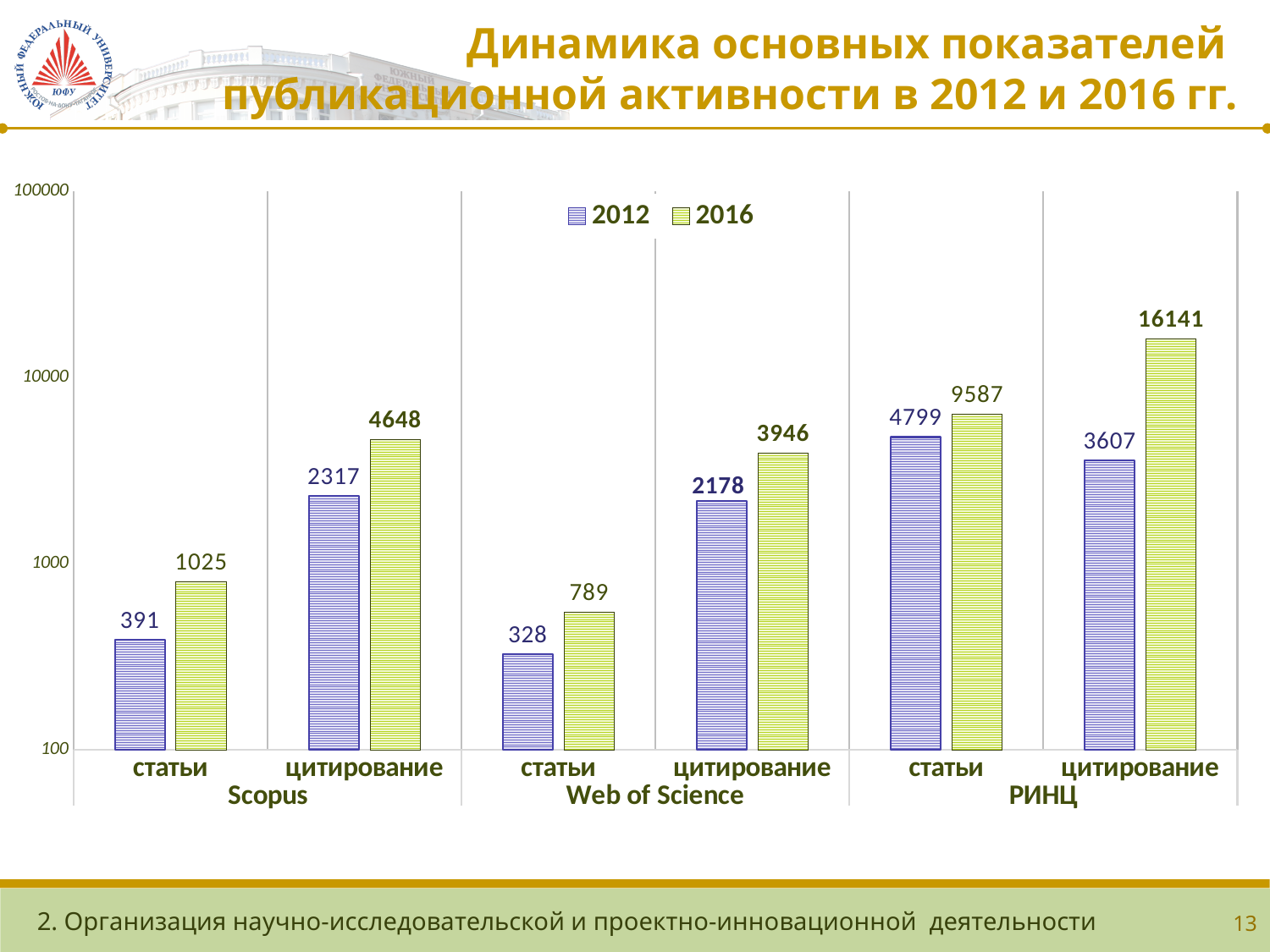
What is the 2016 value for статьи in Web of Science? 789 How many bars are plotted in the chart? 12 Which series is shown in yellow-green in the legend? 2016 Which category has the highest 2016 value? цитирование (РИНЦ) Which is larger: the 2016 value for цитирование in Scopus or the 2016 value for цитирование in Web of Science? цитирование in Scopus (4648) How many series does the legend list? 2 What is the difference between the 2016 and 2012 values for статьи in РИНЦ? 4788 Which category has the lowest 2012 value? статьи (Web of Science) What is the 2016 value for цитирование in РИНЦ? 16141 What kind of chart is shown on the slide? Bar chart What is the 2012 value for статьи in Scopus? 391 What is the 2012 value for цитирование in Web of Science? 2178